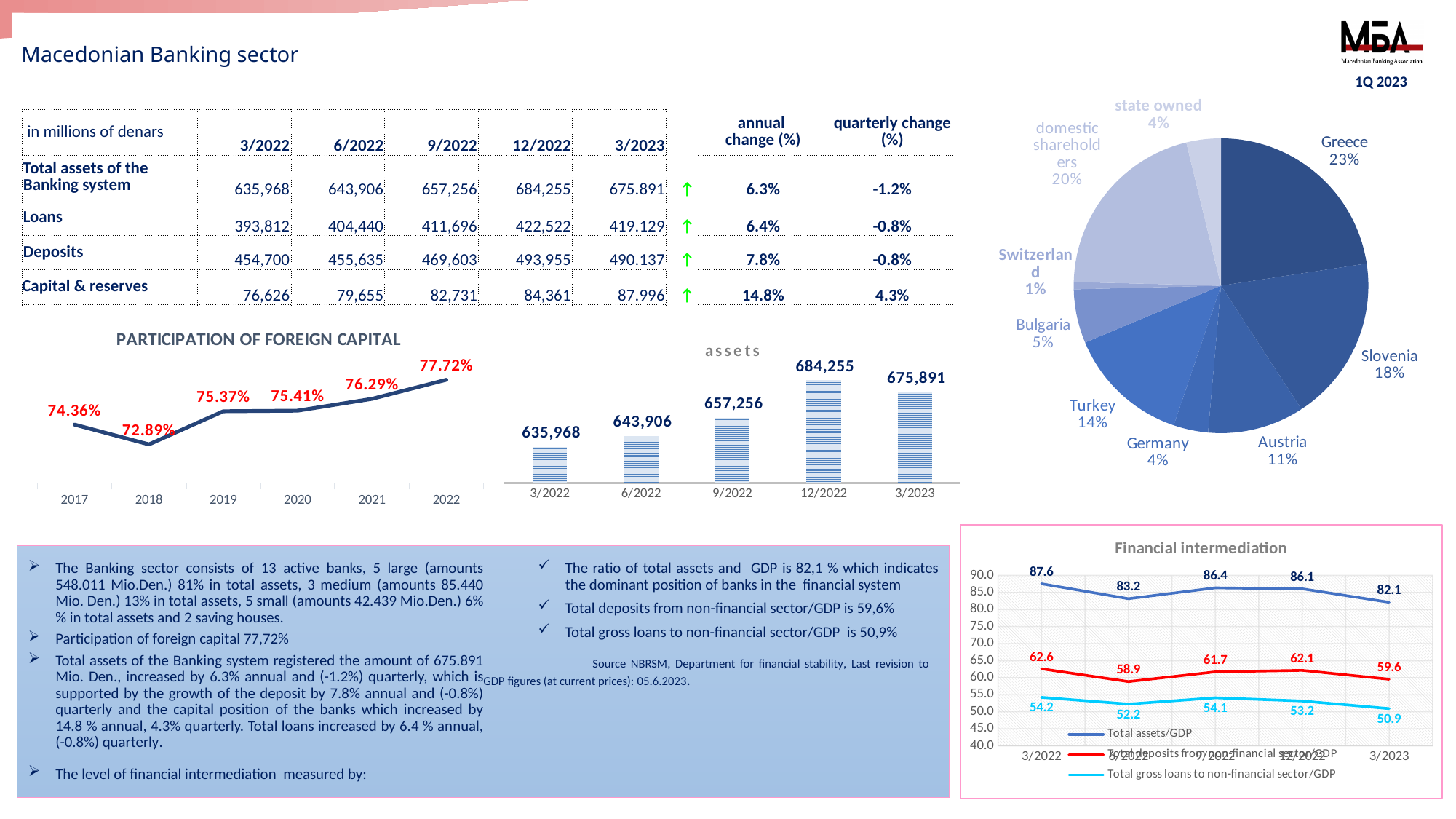
In the pie chart, what share does Greece hold? 23% How many series does the legend of the Financial intermediation chart list? 3 In the pie chart, which slice is the largest? Greece In the assets bar chart, which period has the highest value? 12/2022 What kind of chart is the assets chart? Bar chart In the PARTICIPATION OF FOREIGN CAPITAL chart, what is the value for 2022? 77.72% In the assets bar chart, how many bars are plotted? 5 In the pie chart, which is larger, Turkey or Austria? Turkey In the PARTICIPATION OF FOREIGN CAPITAL chart, which year has the lowest value? 2018 In the assets bar chart, what is the value for 12/2022? 684,255 In the PARTICIPATION OF FOREIGN CAPITAL chart, what is the difference between the 2022 and 2017 values? 3.36 percentage points In the Financial intermediation chart, what is the value of Total assets/GDP for 3/2023? 82.1